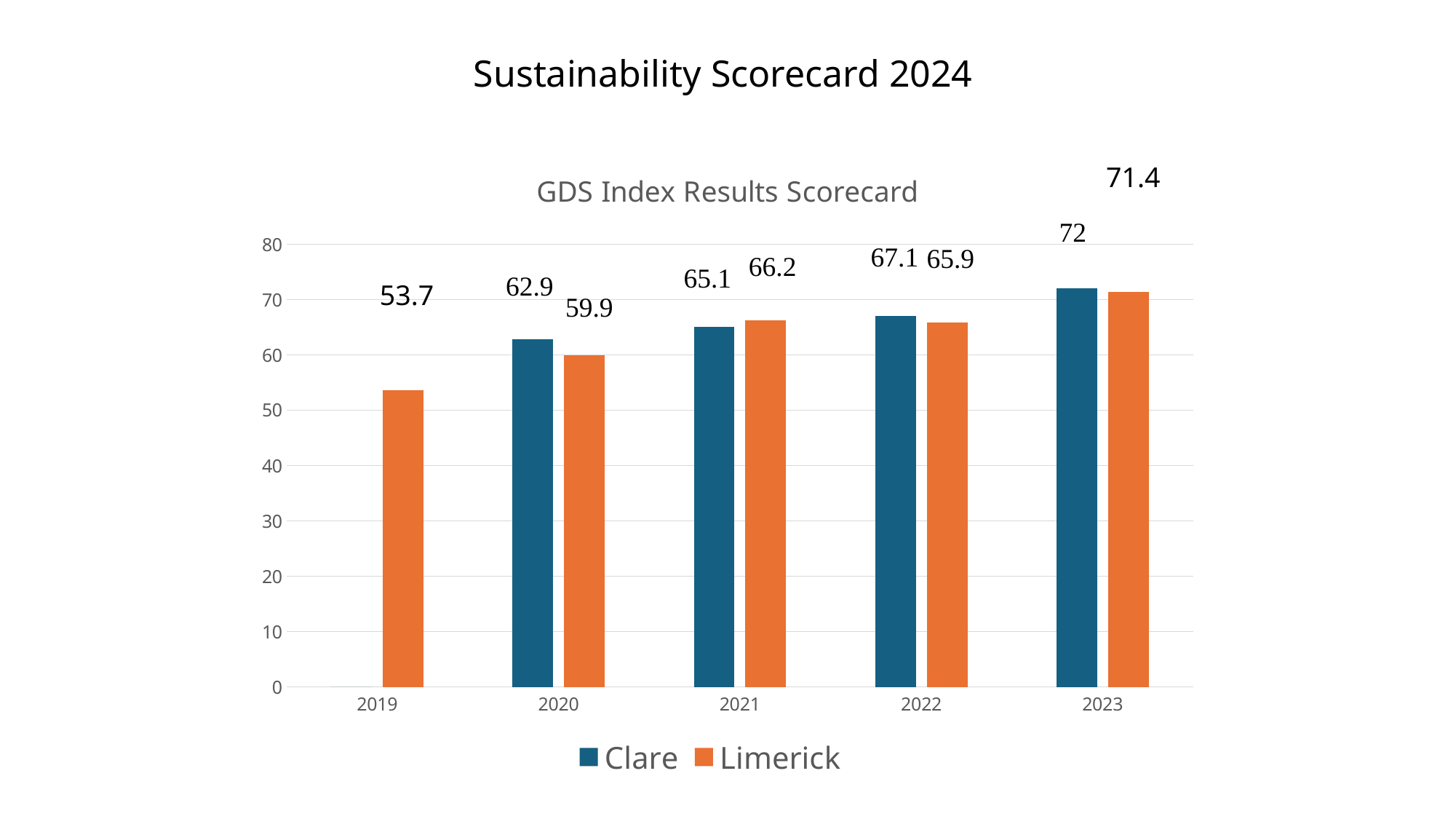
Is the value for Limerick in 2019 greater or less than 60? less What is the value for Clare in 2020? 62.9 How many years are shown on the x axis? 5 In which year is the Clare value highest? 2023 What is the value for Limerick in 2023? 71.4 What is the value for Limerick in 2019? 53.7 In which year is the Limerick value lowest? 2019 What is the difference between the Clare and Limerick values in 2020? 3 How many series does the legend list? 2 What is the value for Clare in 2022? 67.1 What kind of chart is shown? bar chart Which is larger in 2021, the Clare value or the Limerick value? Limerick